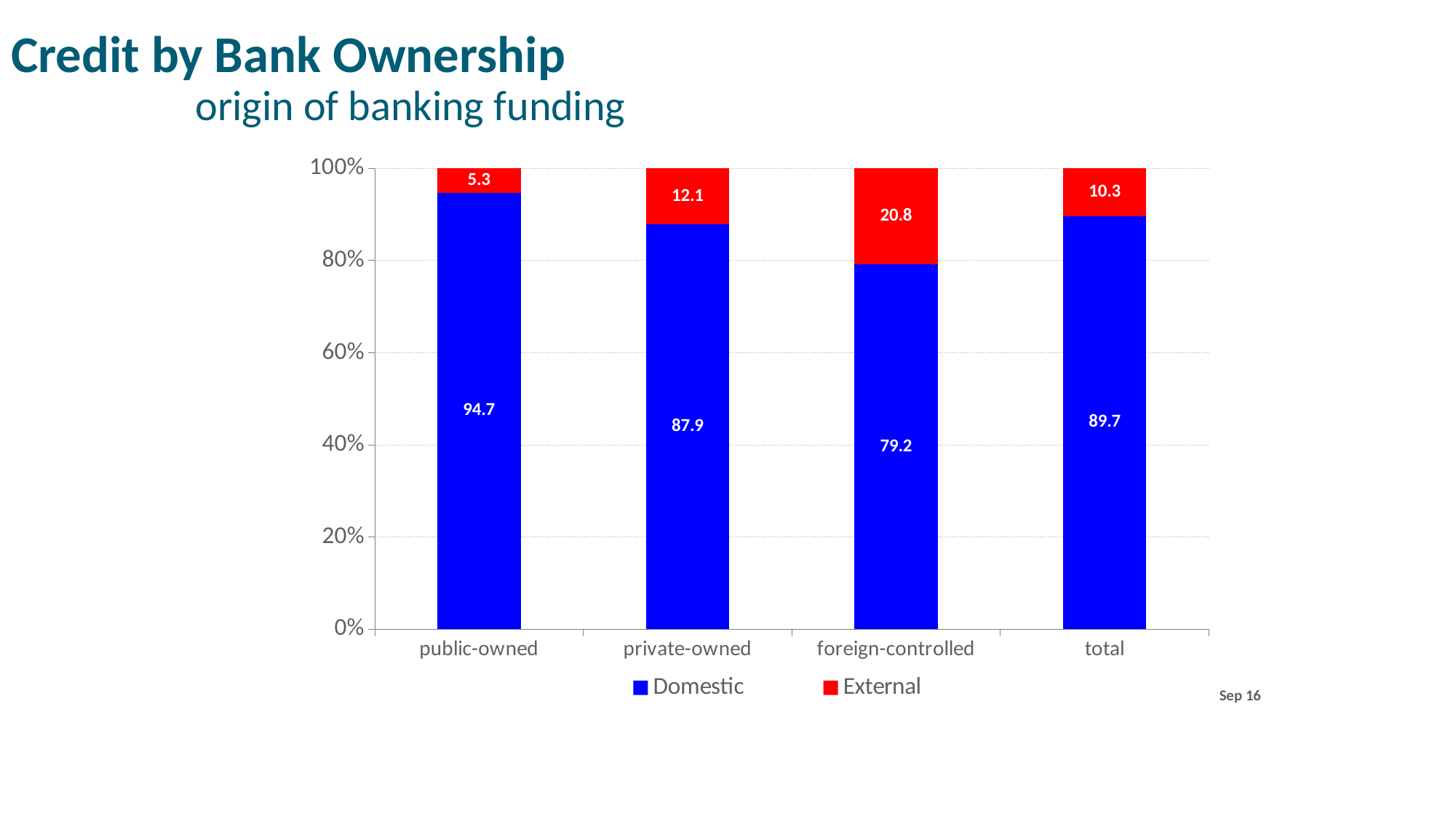
Which category has the lowest Domestic value? foreign-controlled What is the Domestic value for private-owned banks? 87.9 What is the difference between the External values for foreign-controlled and public-owned banks? 15.5 What is the Domestic value for public-owned banks? 94.7 Which category has the highest External value? foreign-controlled Which is larger, the Domestic value for private-owned banks or for the total? total What is the External value for the total category? 10.3 What is the External value for foreign-controlled banks? 20.8 How many categories are shown on the x axis? 4 Which colour represents the External series? red What kind of chart is shown on the slide? stacked bar chart How many series does the legend list? 2